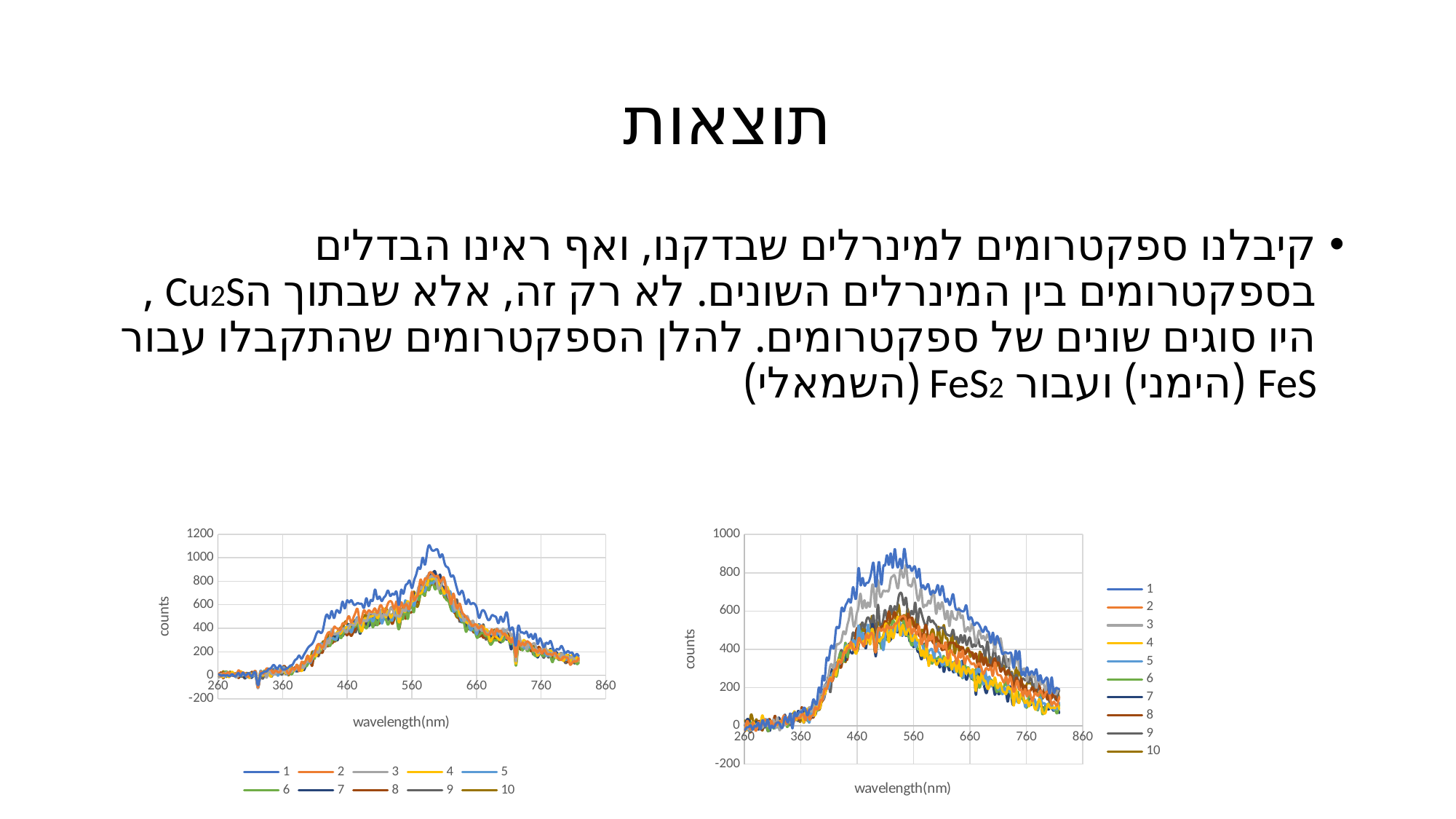
In the right chart, which series has the higher peak, series 1 or series 4? 1 What kind of chart is the chart on the right of the slide? line chart How many series does the legend of the left chart list? 10 In the right chart, is the peak value of series 1 greater or less than 800? greater In the left chart, which series reaches the highest peak? 1 What kind of chart is the chart on the left of the slide? line chart What is the label of the x axis on the left chart? wavelength(nm) How many series does the legend of the right chart list? 10 In the right chart, is the peak value of series 3 greater or less than 600? greater What is the label of the y axis on the right chart? counts In the left chart, is the peak value of series 1 greater or less than 1000? greater In the right chart, which series reaches the highest peak? 1